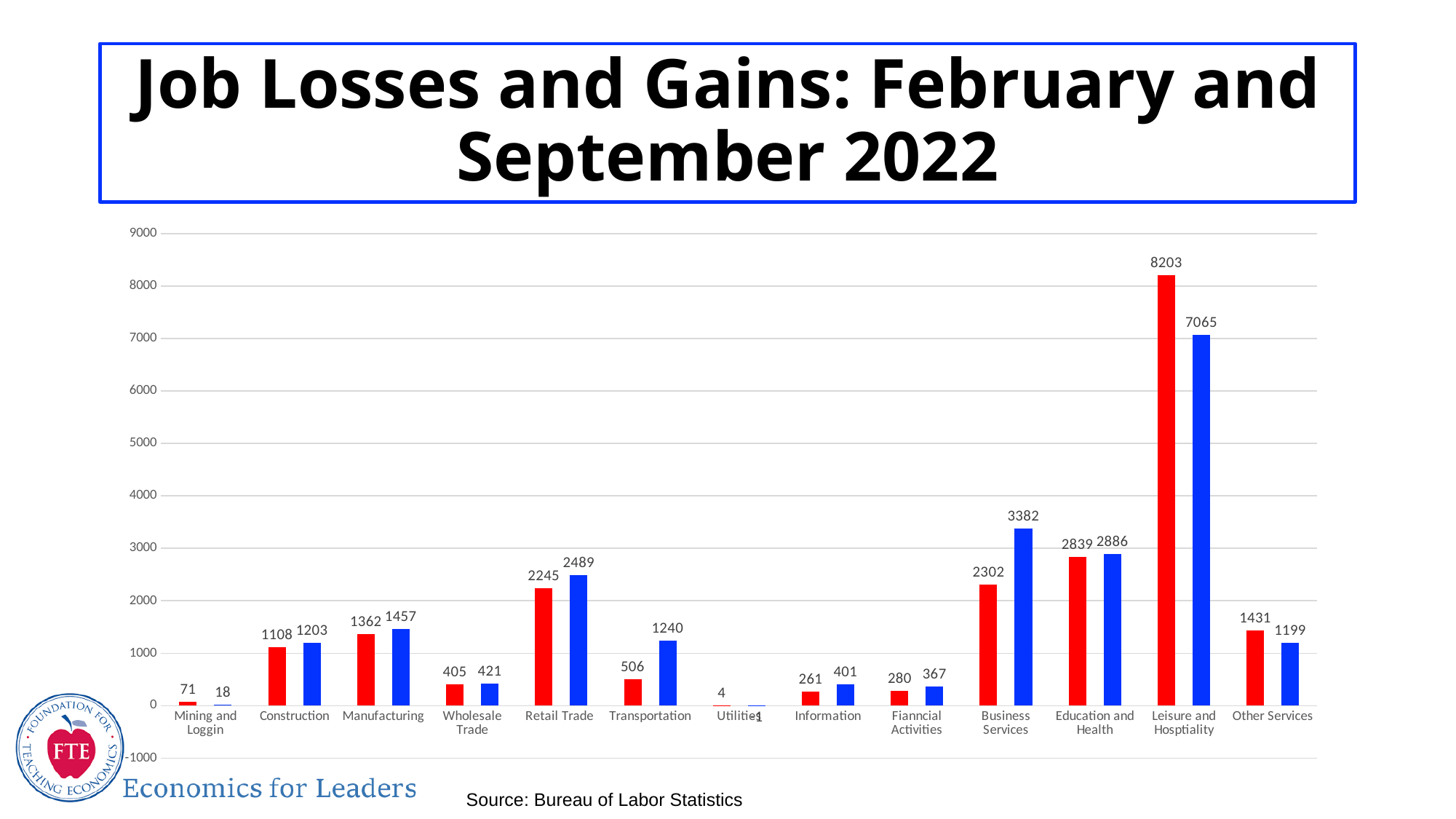
What is the difference between the red bar and the blue bar for Leisure and Hospitality? 1138 What is the title of the chart on the slide? Job Losses and Gains: February and September 2022 What kind of chart is shown on the slide? bar chart What is the value of the blue bar for Business Services? 3382 What is the value of the red bar for Leisure and Hospitality? 8203 How many industry categories are shown on the x axis of the chart? 13 Which category has the highest blue bar? Leisure and Hospitality Is the value of the blue bar for Education and Health greater or less than 2000? greater What is the difference between the blue bar and the red bar for Transportation? 734 What is the value of the red bar for Retail Trade? 2245 Which is larger for Other Services, the red bar or the blue bar? the red bar Which category has the lowest red bar? Utilities